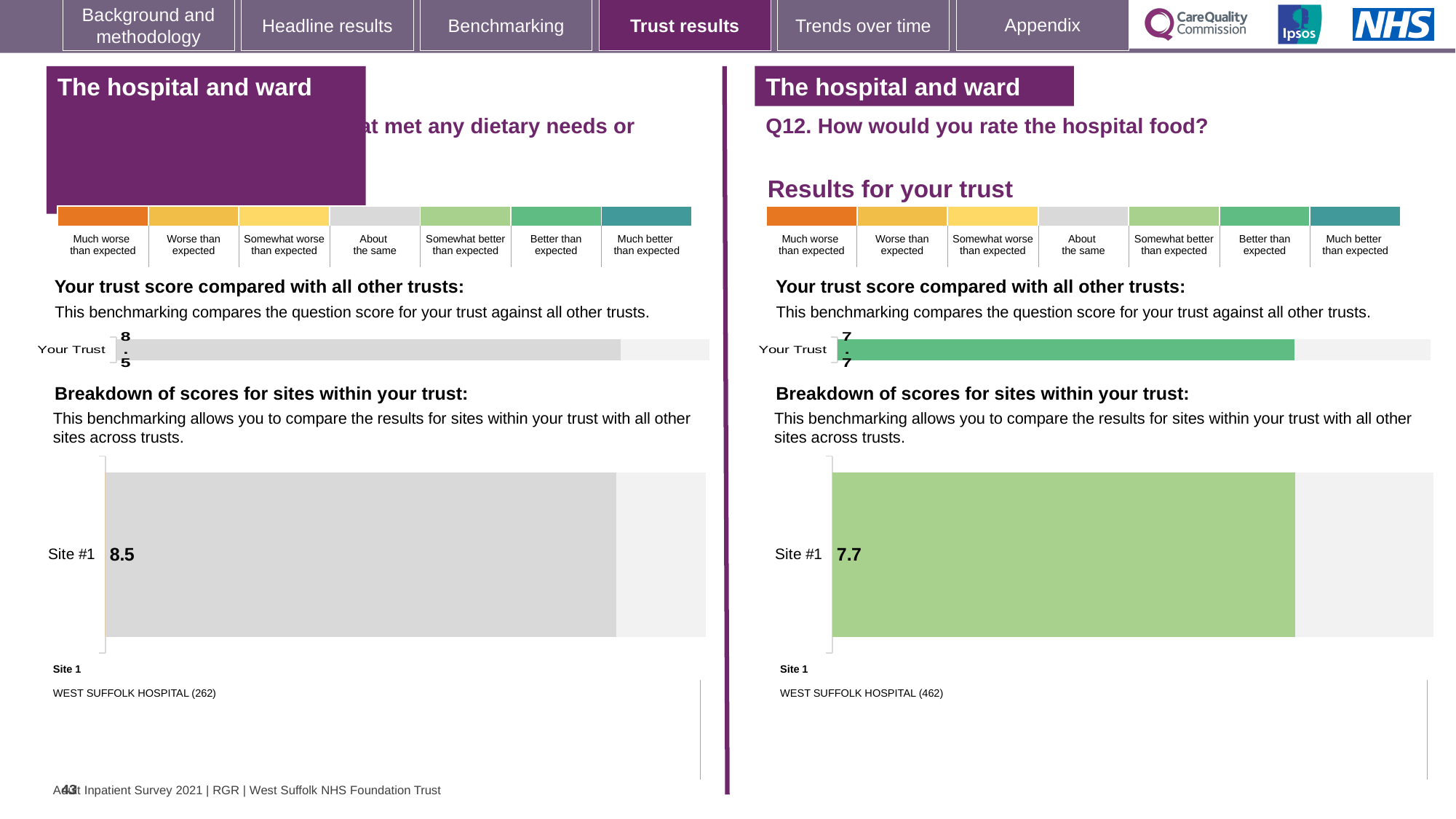
On the left-hand side of the slide, what is the 'Your Trust' score shown in the trust comparison bar? 8.5 How many benchmark categories are shown in the colour key above the 'Your trust score compared with all other trusts' section on the right-hand side of the slide? 7 What is the difference between the Site #1 score on the left-hand chart (8.5) and the Site #1 score on the right-hand chart (7.7)? 0.8 On the left-hand side of the slide, which site name is listed as Site 1 below the chart? WEST SUFFOLK HOSPITAL (262) How many sites are shown in the breakdown of scores chart on the right-hand side of the slide (Q12)? 1 On the left-hand side of the slide, what score is shown for Site #1 in the breakdown of scores for sites? 8.5 On the right-hand side of the slide (Q12), which site name is listed as Site 1 below the chart? WEST SUFFOLK HOSPITAL (462) On the right-hand side of the slide (Q12, hospital food), what is the 'Your Trust' score shown in the trust comparison bar? 7.7 What type of chart is used to show the breakdown of scores for sites within the trust on the right-hand side of the slide? Bar chart On the right-hand side of the slide (Q12), what score is shown for Site #1 in the breakdown of scores for sites? 7.7 Which is larger: the Site #1 score on the left-hand chart or the Site #1 score on the right-hand chart (Q12)? The left-hand chart (8.5)